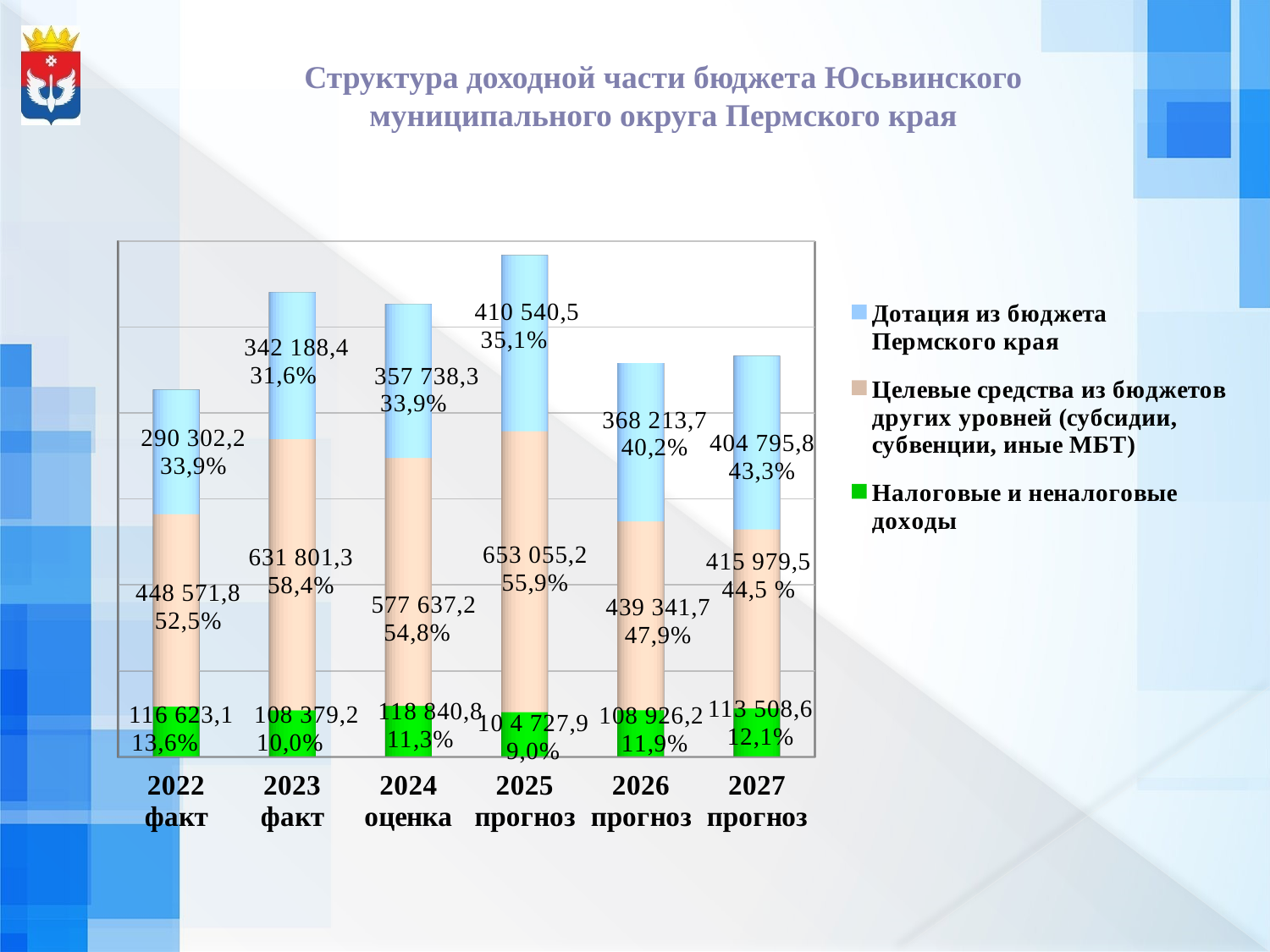
How many series does the chart legend list? 3 What is the value of 'Целевые средства из бюджетов других уровней' for 2023 факт? 631 801,3 What percentage share is shown for 'Налоговые и неналоговые доходы' in 2022 факт? 13,6% In which year is the value of 'Дотация из бюджета Пермского края' the highest? 2025 прогноз What is the total of the stacked bar for 2022 факт? 855 497,1 Which is larger: 'Целевые средства' in 2024 оценка or 'Целевые средства' in 2026 прогноз? 2024 оценка What kind of chart is shown on the slide? Stacked bar chart What is the difference between 'Целевые средства' in 2025 прогноз and in 2022 факт? 204 483,4 What is the value of 'Дотация из бюджета Пермского края' for 2025 прогноз? 410 540,5 How many categories (years) are shown on the x axis of the chart? 6 Which colour represents 'Налоговые и неналоговые доходы' in the chart? Green In which year is the value of 'Налоговые и неналоговые доходы' the lowest? 2025 прогноз